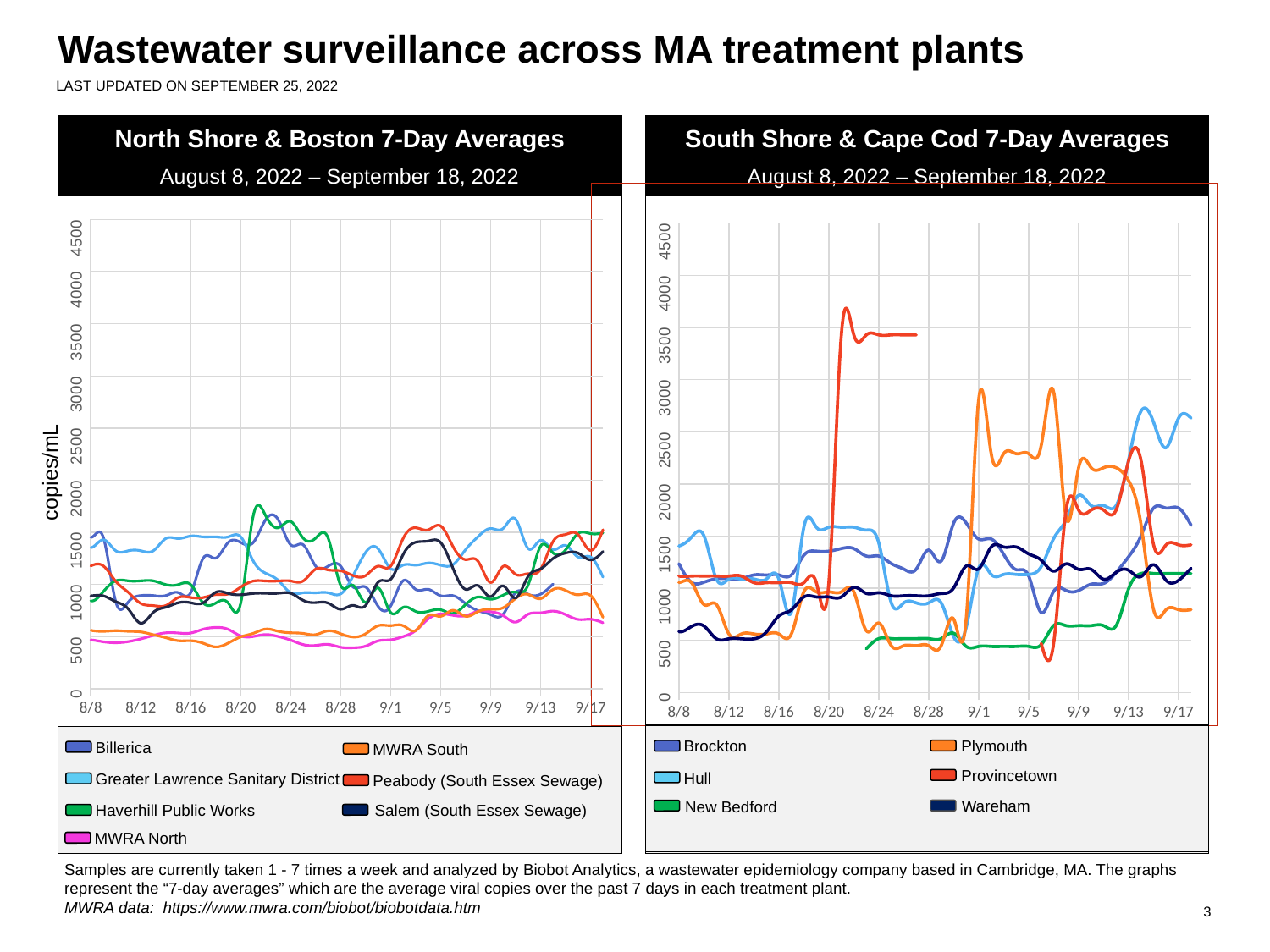
What kind of chart is the North Shore & Boston 7-Day Averages chart? line chart In the South Shore & Cape Cod 7-Day Averages chart, which series reaches the highest value? Provincetown In the South Shore & Cape Cod 7-Day Averages chart, is the value for Wareham on 8/8 greater or less than 1000? less How many series does the legend of the North Shore & Boston 7-Day Averages chart list? 7 In the North Shore & Boston 7-Day Averages chart, is the peak value for Haverhill Public Works greater or less than 1500? greater In the North Shore & Boston 7-Day Averages chart, is the value for MWRA North on 8/8 greater or less than 1000? less How many series does the legend of the South Shore & Cape Cod 7-Day Averages chart list? 6 What date range is shown in the subtitle of the South Shore & Cape Cod 7-Day Averages chart? August 8, 2022 – September 18, 2022 What is the y-axis label shown on the North Shore & Boston 7-Day Averages chart? copies/mL In the South Shore & Cape Cod 7-Day Averages chart, which is larger on 8/24, Provincetown or Wareham? Provincetown